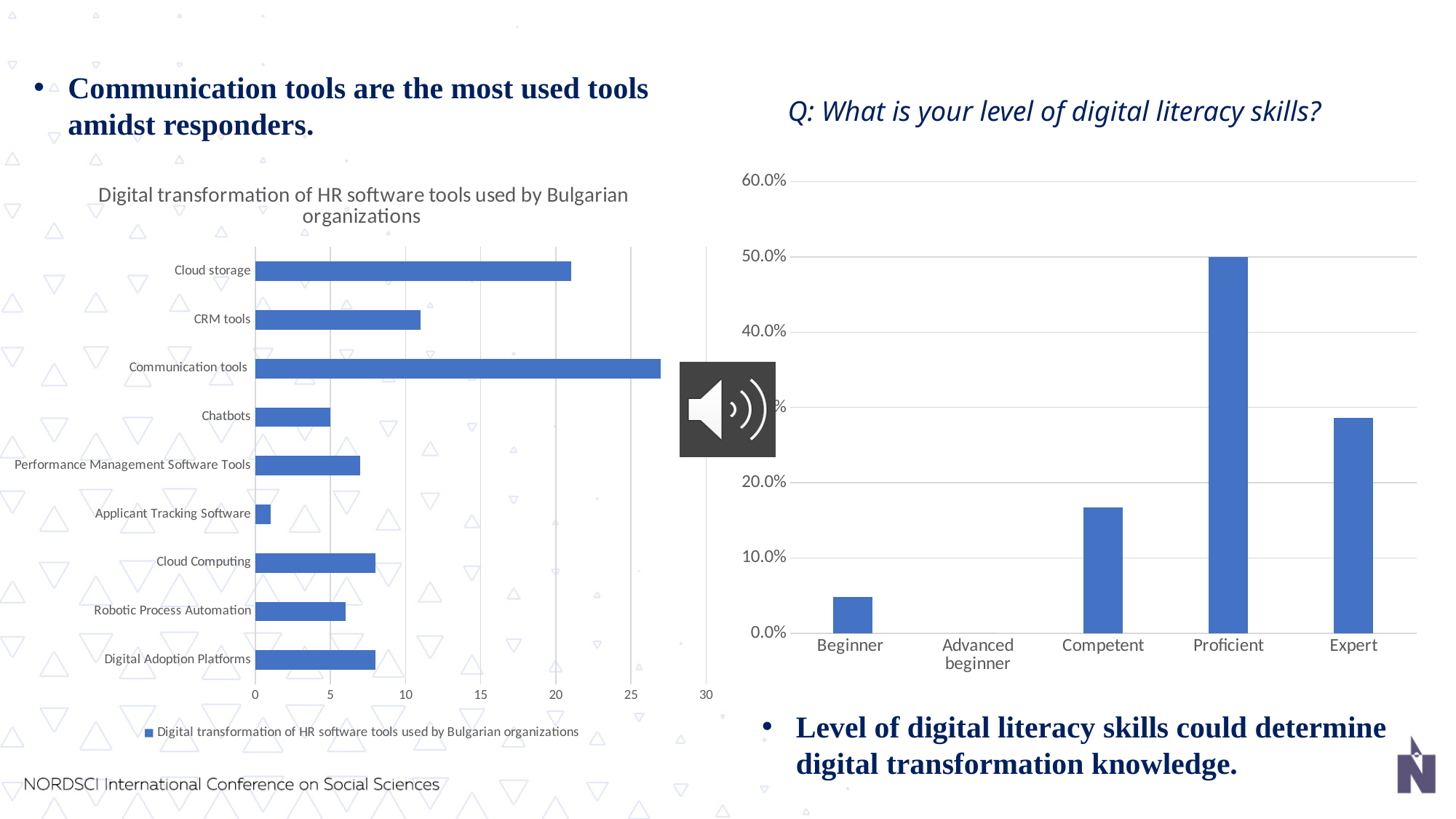
In the chart titled 'Digital transformation of HR software tools used by Bulgarian organizations', which tool has the lowest value? Applicant Tracking Software In the right chart 'Q: What is your level of digital literacy skills?', which is larger: the value for Competent or the value for Beginner? Competent In the chart titled 'Digital transformation of HR software tools used by Bulgarian organizations', which tool has the highest value? Communication tools In the right chart 'Q: What is your level of digital literacy skills?', is the value for Expert greater or less than 20.0%? greater In the left chart about HR software tools, is the value for CRM tools greater or less than 15? less In the right chart 'Q: What is your level of digital literacy skills?', which level has the highest value? Proficient In the left chart about HR software tools, is the value for Cloud storage greater or less than 20? greater In the left chart about HR software tools, how many tool categories are shown? 9 In the right chart 'Q: What is your level of digital literacy skills?', how many skill levels are shown on the x axis? 5 In the left chart about HR software tools, which is larger: the value for Cloud storage or the value for CRM tools? Cloud storage How many series does the legend of the left chart about HR software tools list? 1 What kind of chart is the left chart about HR software tools used by Bulgarian organizations? Bar chart